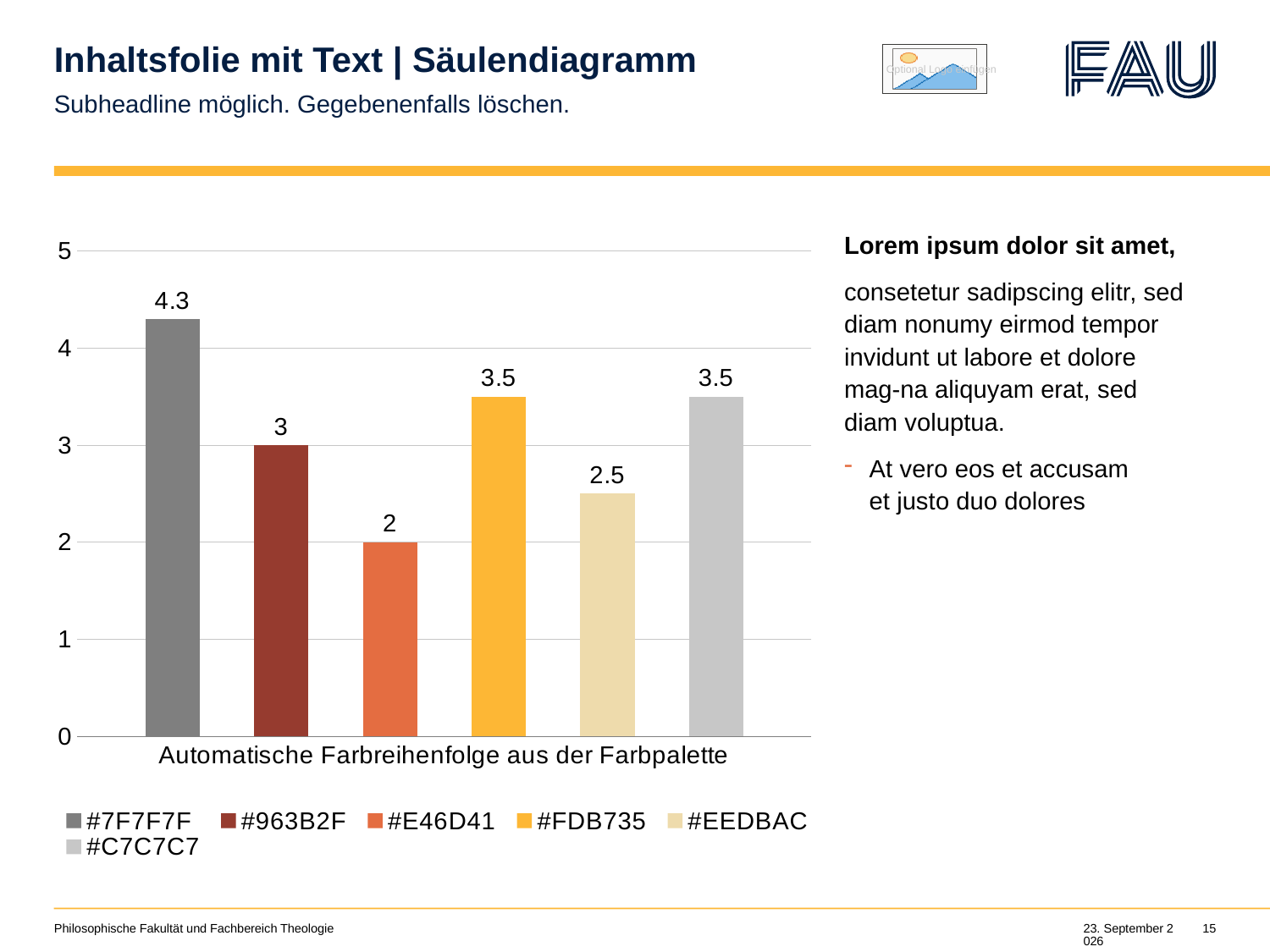
What kind of chart is shown on the slide? Bar chart Which series has the highest value? #7F7F7F What is the difference between the values of #7F7F7F and #E46D41? 2.3 What is the value of the #963B2F series? 3 Which series has the lowest value? #E46D41 What is the value of the #EEDBAC series? 2.5 Which is larger, the value of #963B2F or the value of #EEDBAC? #963B2F What is the category label shown on the x axis? Automatische Farbreihenfolge aus der Farbpalette What is the highest value shown on the y axis? 5 What is the value of the #7F7F7F series? 4.3 What is the value of the #FDB735 series? 3.5 How many series does the legend list? 6